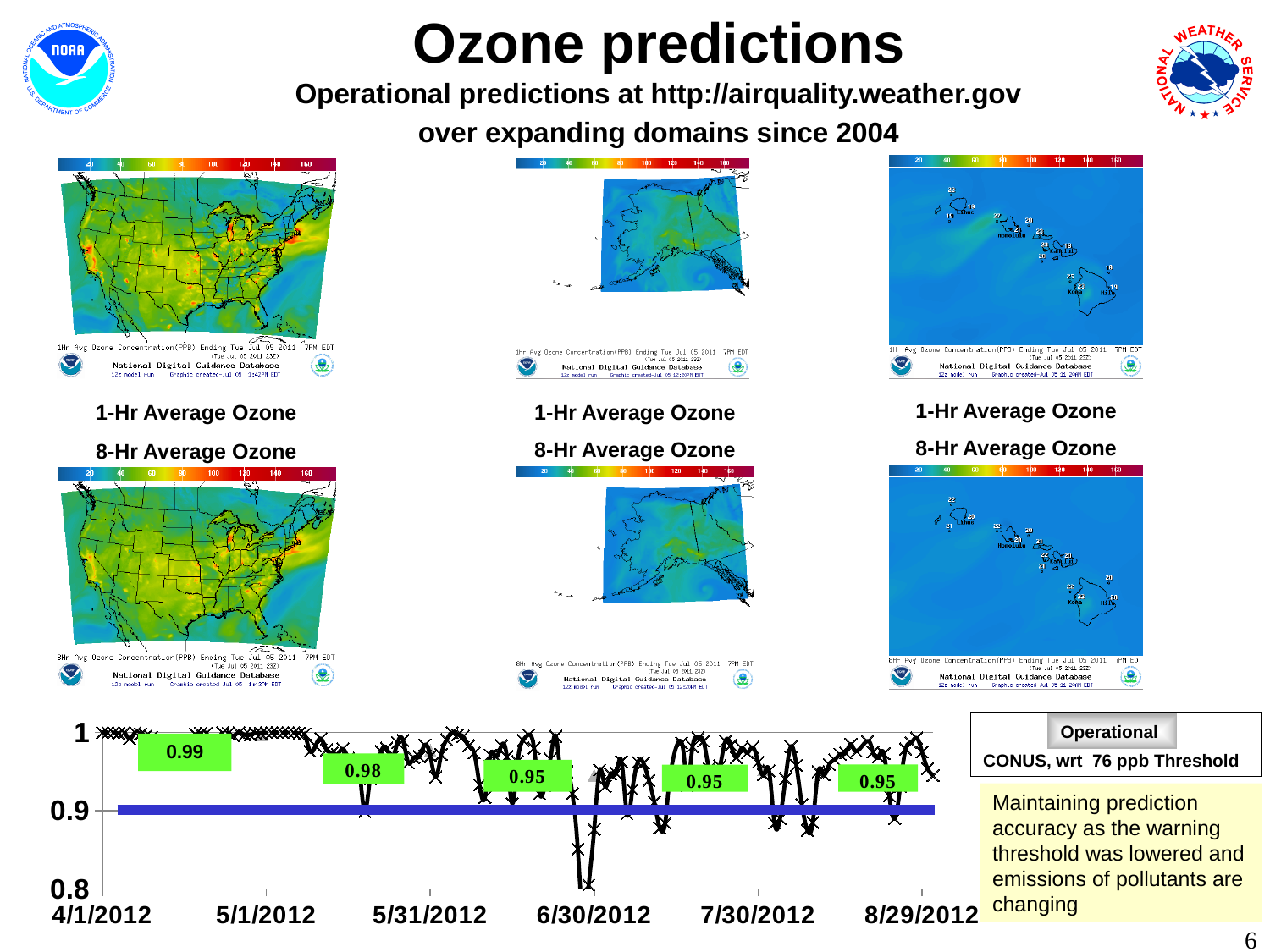
What kind of chart is shown at the bottom of the slide? line chart In the bottom chart, what is the lowest labelled value? 0.95 In the bottom chart, do the labelled values rise or fall from April to August 2012? fall How many date labels are shown on the x axis of the bottom chart? 6 At what value is the horizontal blue reference line drawn in the bottom chart? 0.9 In the bottom chart, what is the second labelled value, shown between 5/1/2012 and 5/31/2012? 0.98 In the bottom chart, what is the first labelled value, near the start of April 2012? 0.99 In the bottom chart, what is the labelled value shown just before 6/30/2012? 0.95 What is the last date label on the x axis of the bottom chart? 8/29/2012 In the bottom chart, which is the highest of the labelled values? 0.99 In the bottom chart, is the lowest point of the line, near 6/30/2012, greater or less than 0.9? less In the bottom chart, what is the difference between the first labelled value (0.99) and the last labelled value (0.95)? 0.04